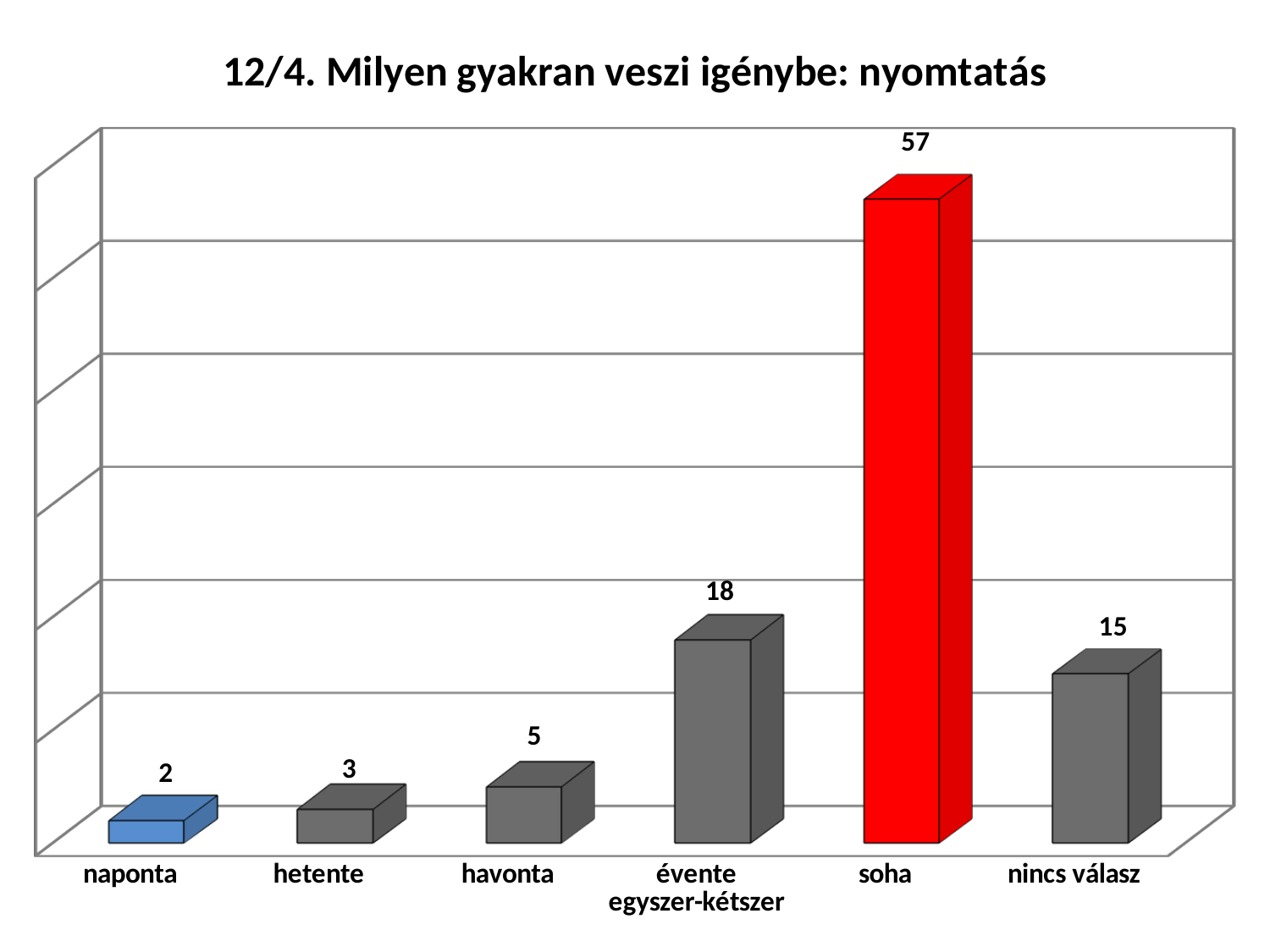
What is the value for "nincs válasz"? 15 How many categories are shown on the x axis? 6 What is the difference between the values for "soha" and "évente egyszer-kétszer"? 39 What is the difference between the values for "havonta" and "hetente"? 2 What is the value for "soha"? 57 What is the value for "évente egyszer-kétszer"? 18 What is the value for "naponta"? 2 Which category has the highest value? soha Which category has the lowest value? naponta What is the title of the chart? 12/4. Milyen gyakran veszi igénybe: nyomtatás Which is larger, the value for "nincs válasz" or the value for "évente egyszer-kétszer"? évente egyszer-kétszer What kind of chart is this? bar chart